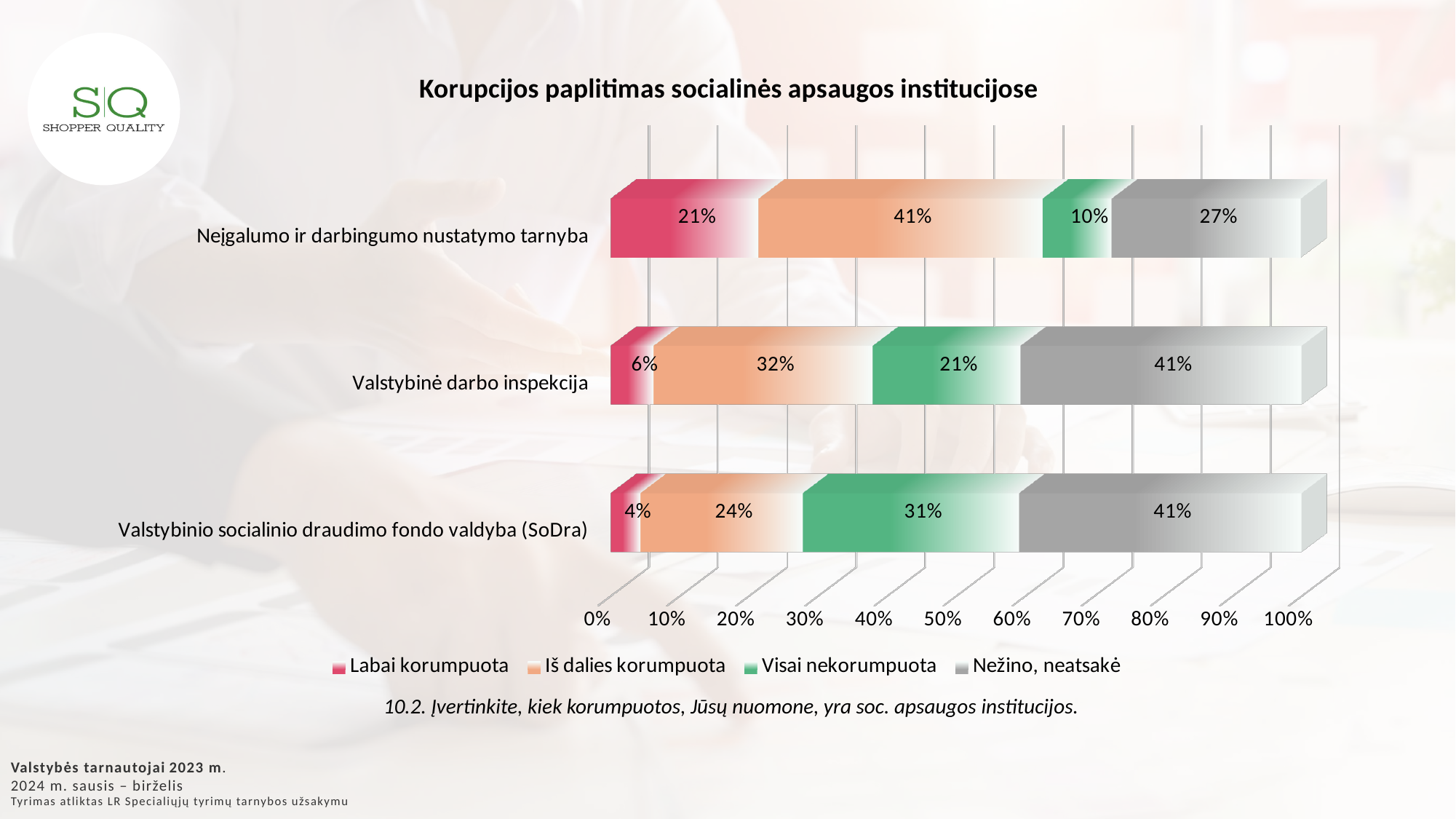
What is the 'Visai nekorumpuota' value for Valstybinio socialinio draudimo fondo valdyba (SoDra)? 31% What is the title of the chart? Korupcijos paplitimas socialinės apsaugos institucijose How many institutions are shown on the chart? 3 Which is larger: the 'Iš dalies korumpuota' value for Valstybinė darbo inspekcija or for SoDra? Valstybinė darbo inspekcija Which institution has the lowest 'Iš dalies korumpuota' share? Valstybinio socialinio draudimo fondo valdyba (SoDra) What is the 'Nežino, neatsakė' value for Valstybinė darbo inspekcija? 41% What is the difference between the 'Visai nekorumpuota' values for SoDra and Neįgalumo ir darbingumo nustatymo tarnyba? 21% Which institution has the highest 'Labai korumpuota' share? Neįgalumo ir darbingumo nustatymo tarnyba What kind of chart is shown on the slide? Stacked bar chart What is the total of the 'Labai korumpuota' and 'Iš dalies korumpuota' segments for Neįgalumo ir darbingumo nustatymo tarnyba? 62% What percentage of respondents rated Neįgalumo ir darbingumo nustatymo tarnyba as 'Labai korumpuota'? 21% How many series does the legend list? 4